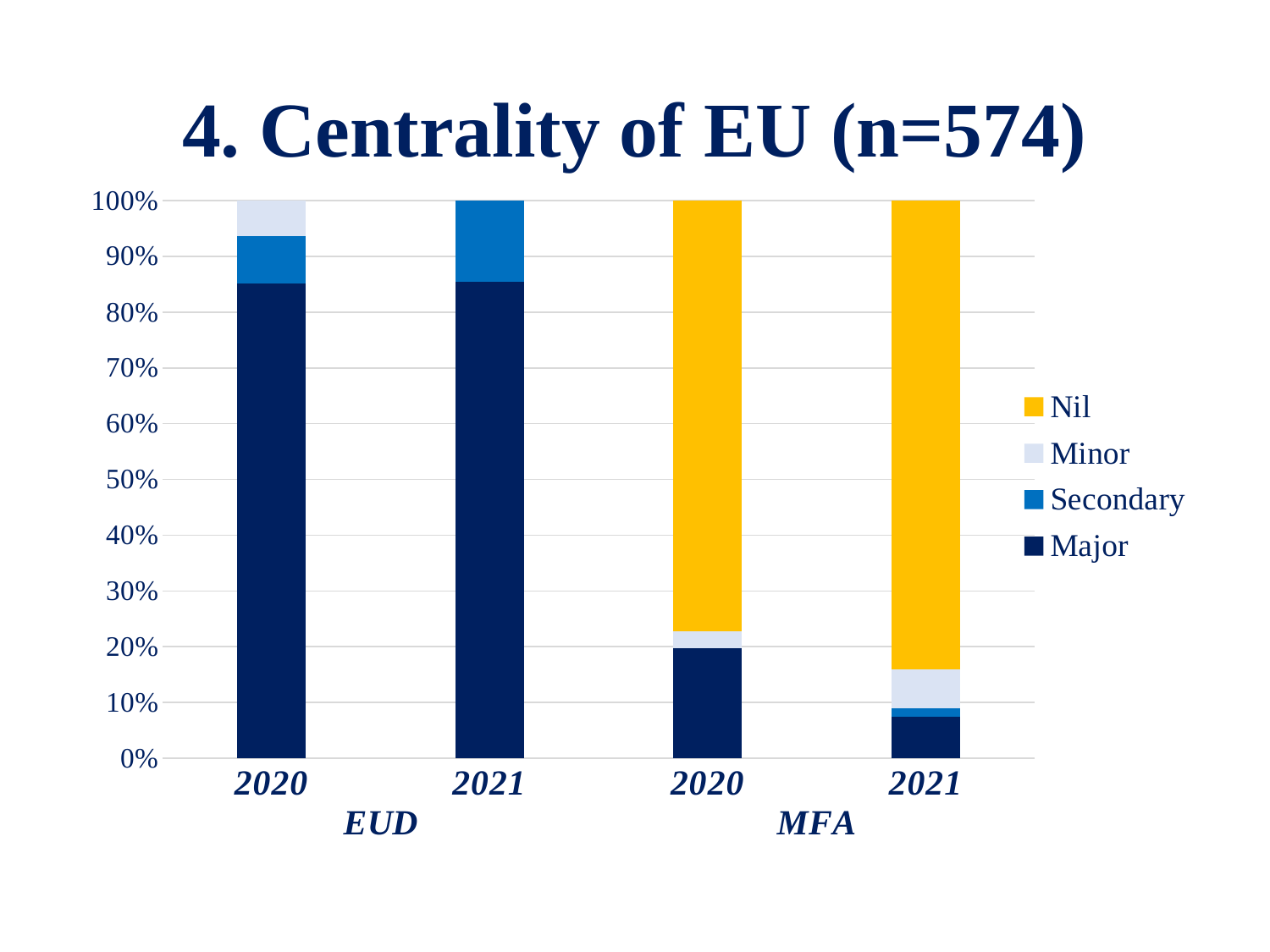
Is the Major share for EUD 2020 greater or less than 80%? greater Which series is shown in yellow in the legend? Nil How many bars are plotted in the chart? 4 What kind of chart is shown on the slide? Stacked bar chart Is the Nil share for MFA 2020 greater or less than 70%? greater Does the Major share for MFA rise or fall from 2020 to 2021? fall Which has the larger Major share, EUD 2020 or MFA 2020? EUD 2020 How many series does the legend list? 4 Is the Major share for MFA 2021 greater or less than 10%? less What is the title of the chart? 4. Centrality of EU (n=574) Which has the larger Nil share, MFA 2020 or MFA 2021? MFA 2021 Which bar has the smallest Major share? MFA 2021